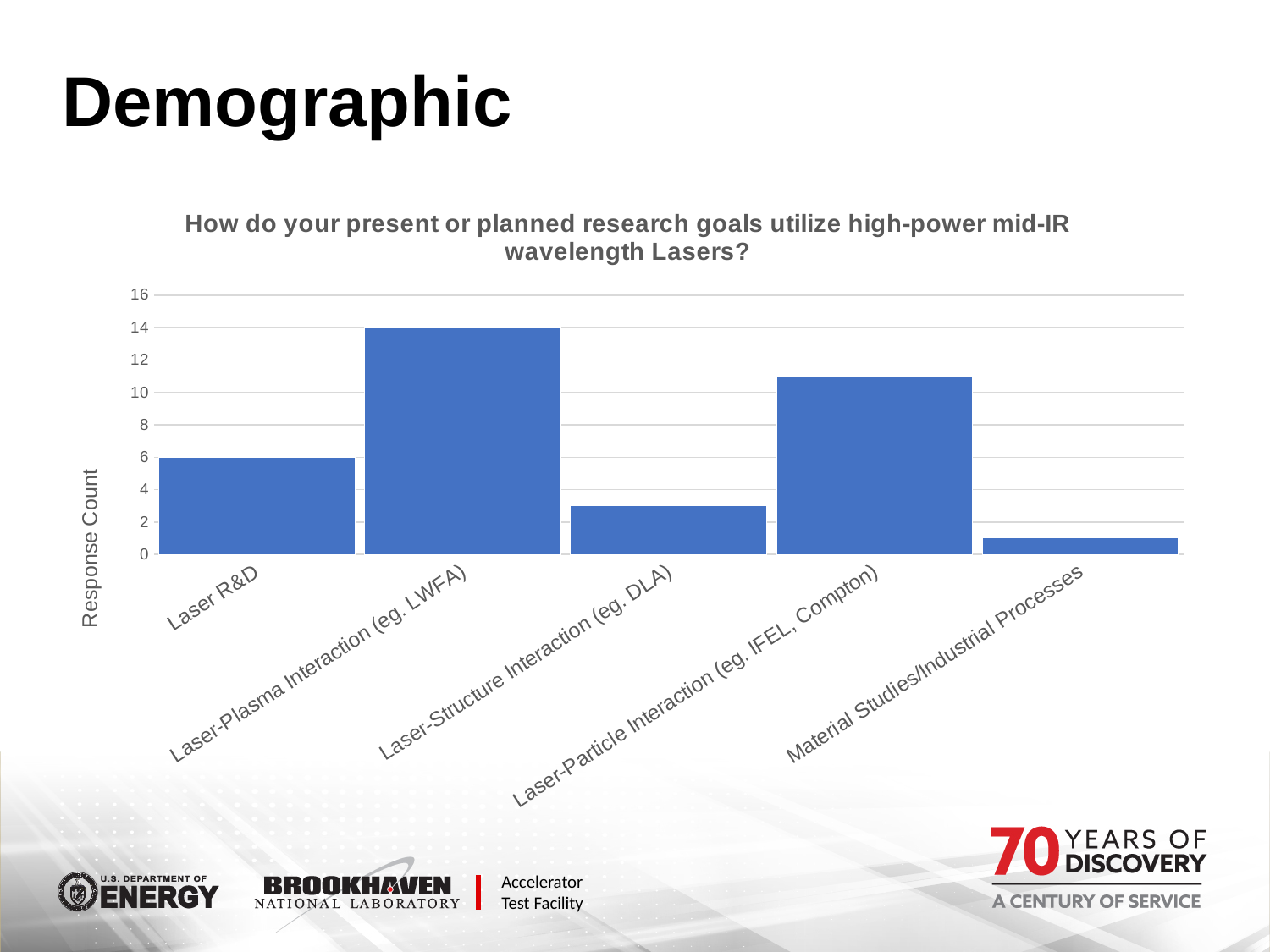
Which category has the highest response count? Laser-Plasma Interaction (eg. LWFA) Which has a larger response count, Laser-Particle Interaction (eg. IFEL, Compton) or Laser-Structure Interaction (eg. DLA)? Laser-Particle Interaction (eg. IFEL, Compton) What type of chart is shown on the slide? bar chart Is the response count for Laser-Structure Interaction (eg. DLA) greater or less than 4? less What is the response count for Laser R&D? 6 What is the response count for Laser-Plasma Interaction (eg. LWFA)? 14 What is the label of the y axis of the chart? Response Count What is the difference in response count between Laser-Plasma Interaction (eg. LWFA) and Laser R&D? 8 Which category has the lowest response count? Material Studies/Industrial Processes How many categories are shown on the x axis of the chart? 5 Is the response count for Material Studies/Industrial Processes greater or less than 2? less Is the response count for Laser-Particle Interaction (eg. IFEL, Compton) greater or less than 10? greater